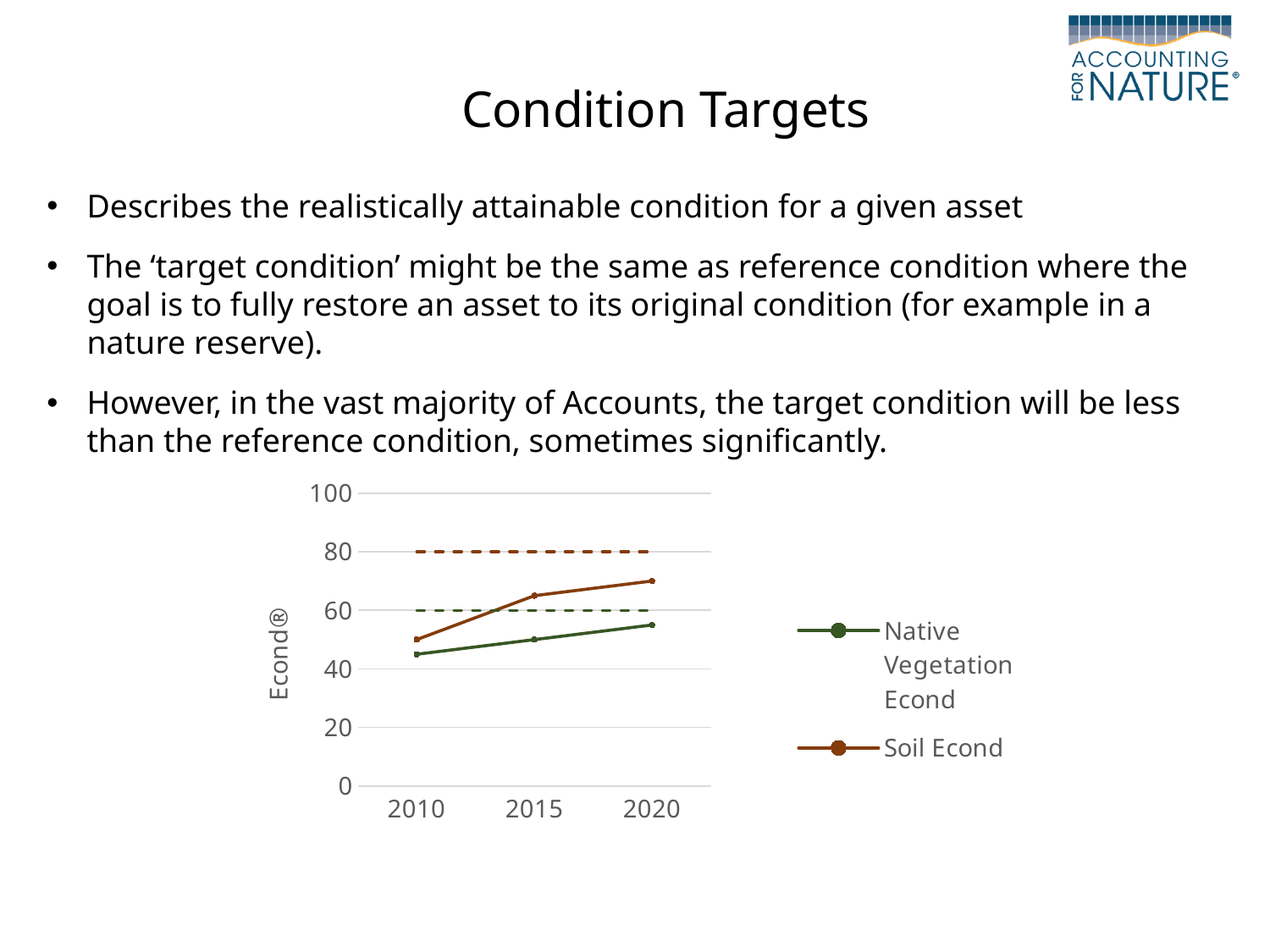
How many series does the chart legend list? 2 Is the Soil Econd value for 2020 greater or less than 60? greater What kind of chart is shown on the slide? line chart In 2020, which series has the higher value, Soil Econd or Native Vegetation Econd? Soil Econd Is the Native Vegetation Econd value for 2010 greater or less than 60? less Is the Native Vegetation Econd value for 2020 greater or less than 60? less Does the Soil Econd line rise or fall from 2010 to 2020? rises What is the label on the y axis of the chart? Econd® How many years are shown on the x axis of the chart? 3 What are the two series named in the chart legend? Native Vegetation Econd and Soil Econd Does the Native Vegetation Econd line rise or fall from 2010 to 2020? rises